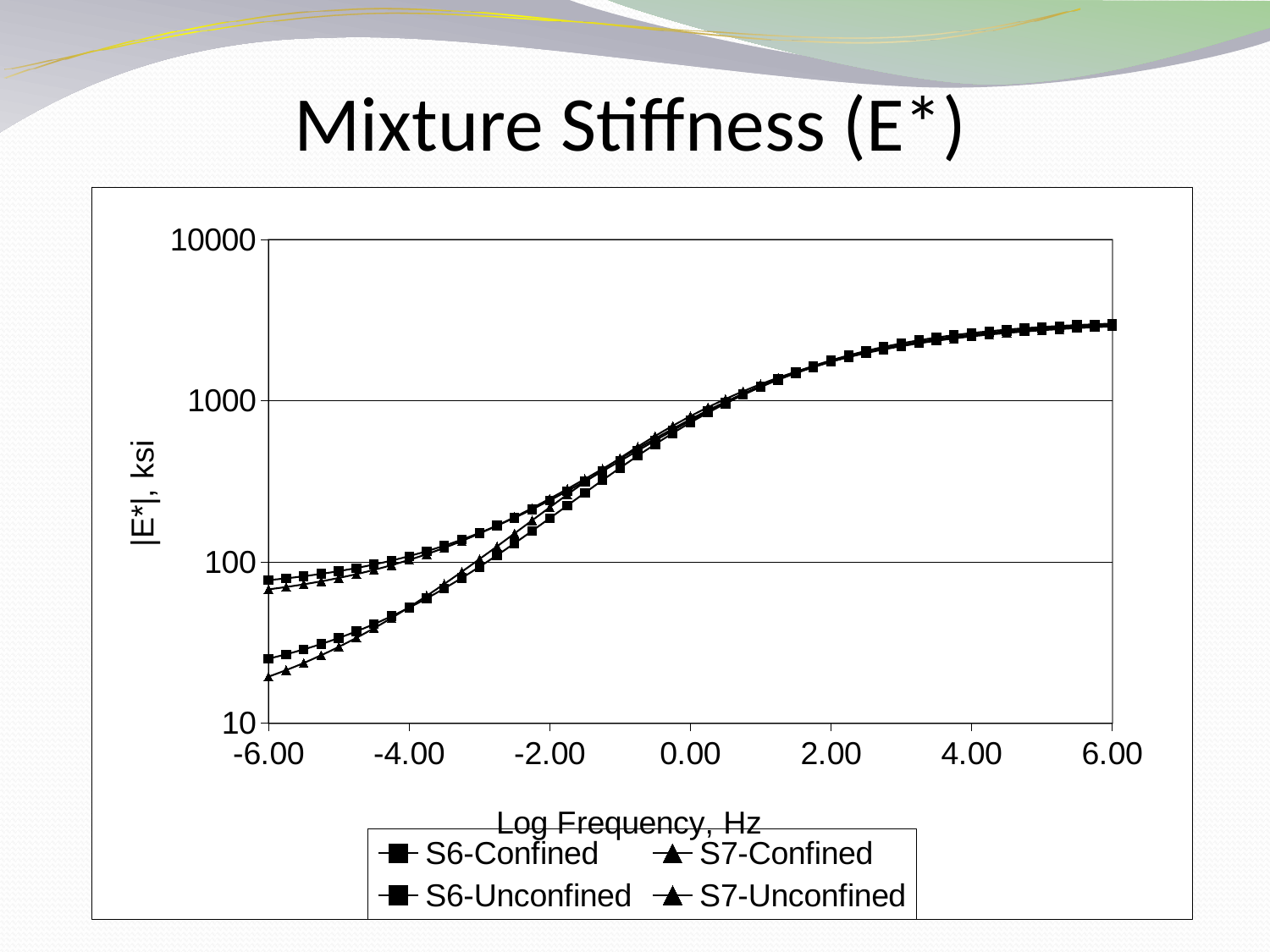
At a log frequency of 2.00, is the value for S6-Unconfined greater or less than 1000? greater What is the label of the x axis? Log Frequency, Hz Do the values of the series rise or fall as log frequency increases from -6.00 to 6.00? rise At a log frequency of 6.00, is the value for S7-Confined greater or less than 1000? greater What kind of chart is shown on the slide? line chart At a log frequency of -6.00, is the value for S7-Unconfined greater or less than 100? less What is the title of the chart? Mixture Stiffness (E*) How many series does the legend list? 4 What is the highest tick value shown on the y axis? 10000